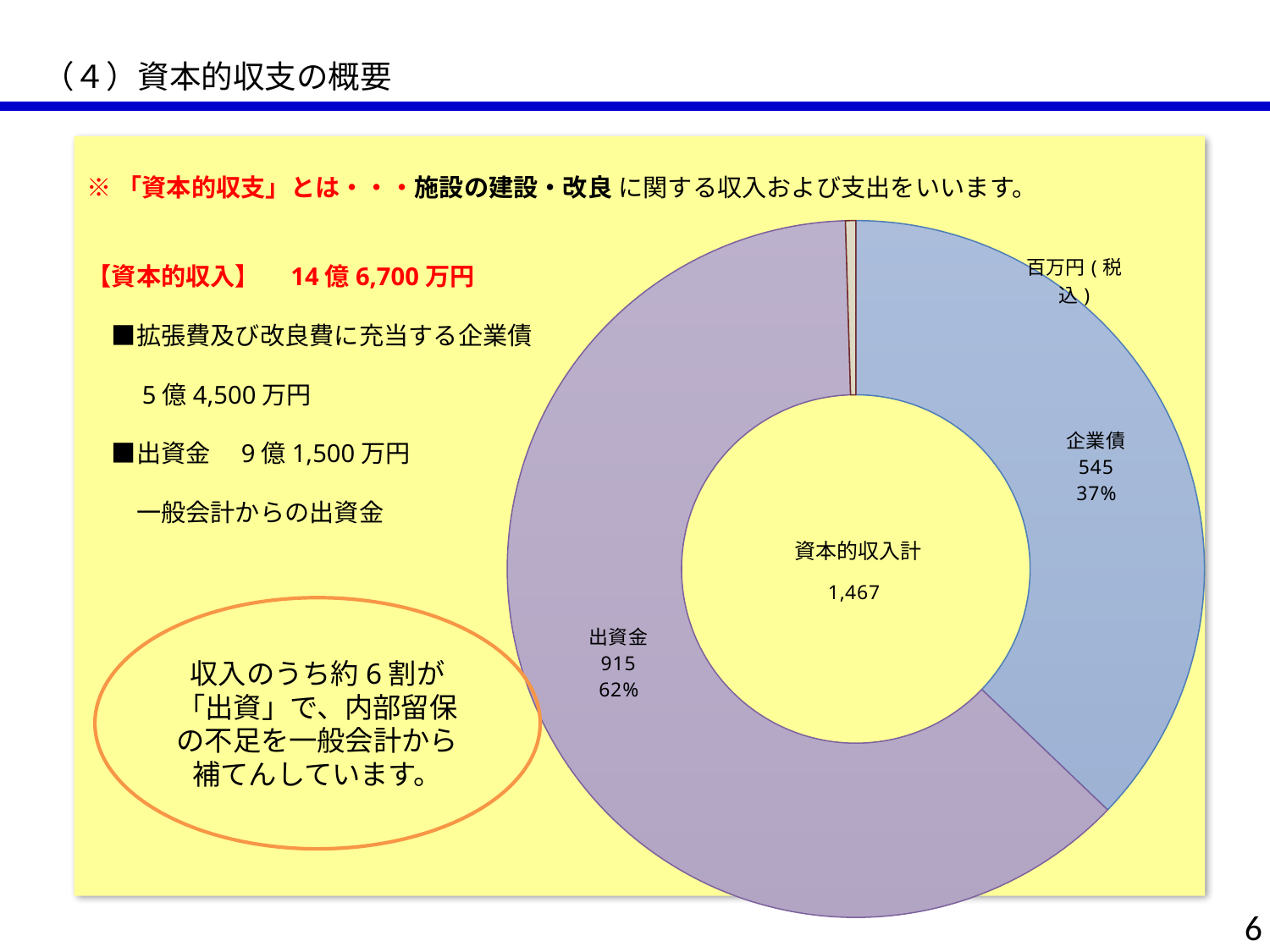
What share of the doughnut chart does 企業債 represent? 37% Which labeled slice of the doughnut chart is the largest? 出資金 What kind of chart is shown on the slide? Doughnut chart What is the difference between the values for 出資金 and 企業債? 370 What share of the doughnut chart does 出資金 represent? 62% What total (資本的収入計) is shown in the center of the doughnut chart? 1,467 Which is larger, the value for 企業債 or the value for 出資金? 出資金 What unit is indicated for the values in the doughnut chart? 百万円(税込) What is the value for 企業債 in the doughnut chart? 545 What is the value for 出資金 in the doughnut chart? 915 Which of the two labeled slices, 企業債 or 出資金, is smaller? 企業債 What label appears in the center of the doughnut chart above the total? 資本的収入計